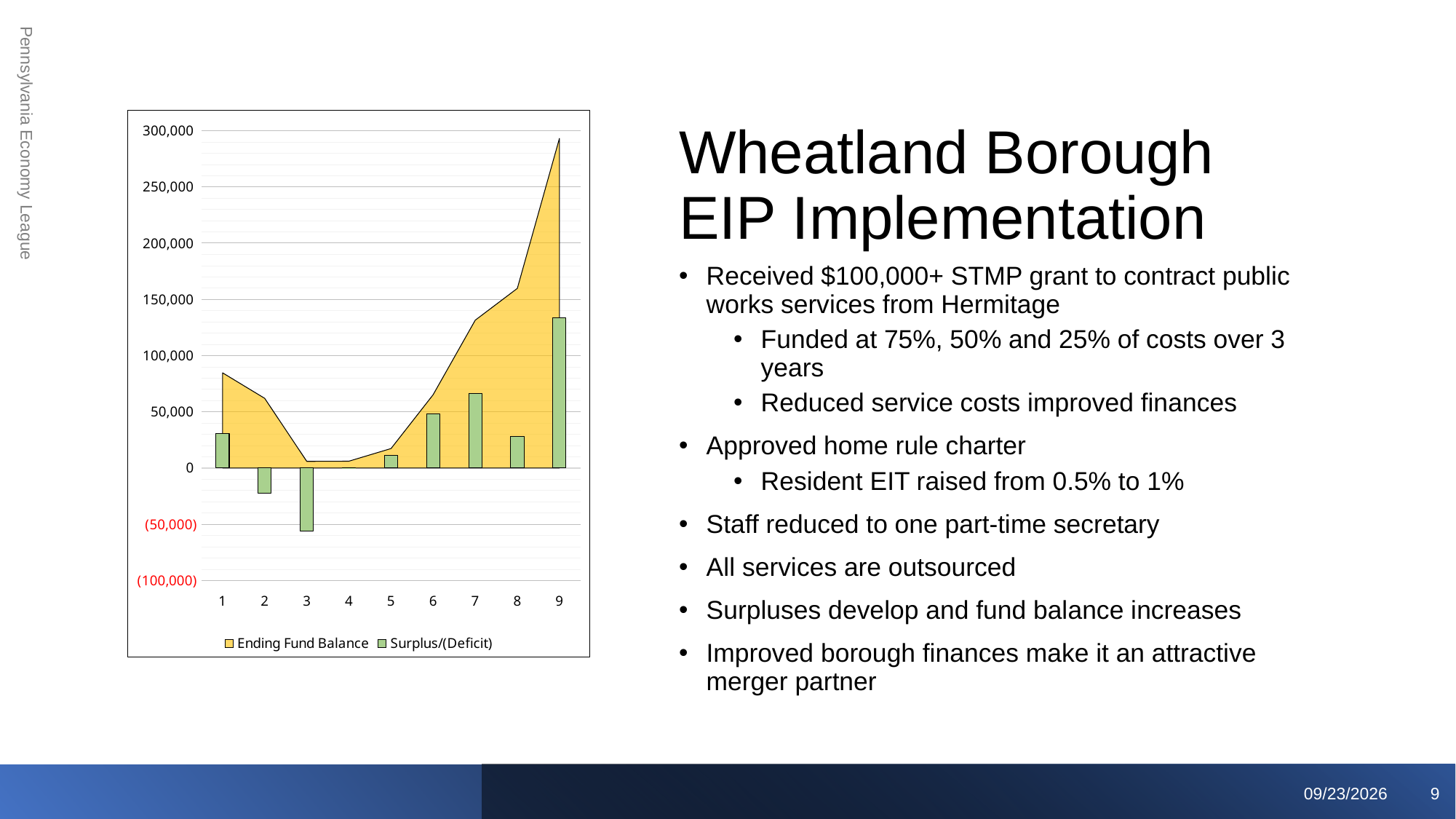
Is the Surplus/(Deficit) value for category 3 greater or less than 0? less Does the Ending Fund Balance rise or fall from category 4 to category 9? Rises Is the Ending Fund Balance for category 9 greater or less than 250,000? greater Is the Ending Fund Balance for category 1 greater or less than 50,000? greater How many categories are shown along the x axis of the chart? 9 What are the two series named in the chart legend? Ending Fund Balance and Surplus/(Deficit) Which category has the highest Surplus/(Deficit) value? 9 Which category has the highest Ending Fund Balance? 9 Which category has the lowest Surplus/(Deficit) value? 3 How is the Surplus/(Deficit) series drawn on the chart? As bars Which is larger, the Surplus/(Deficit) for category 7 or for category 8? Category 7 How many series does the chart legend list? 2